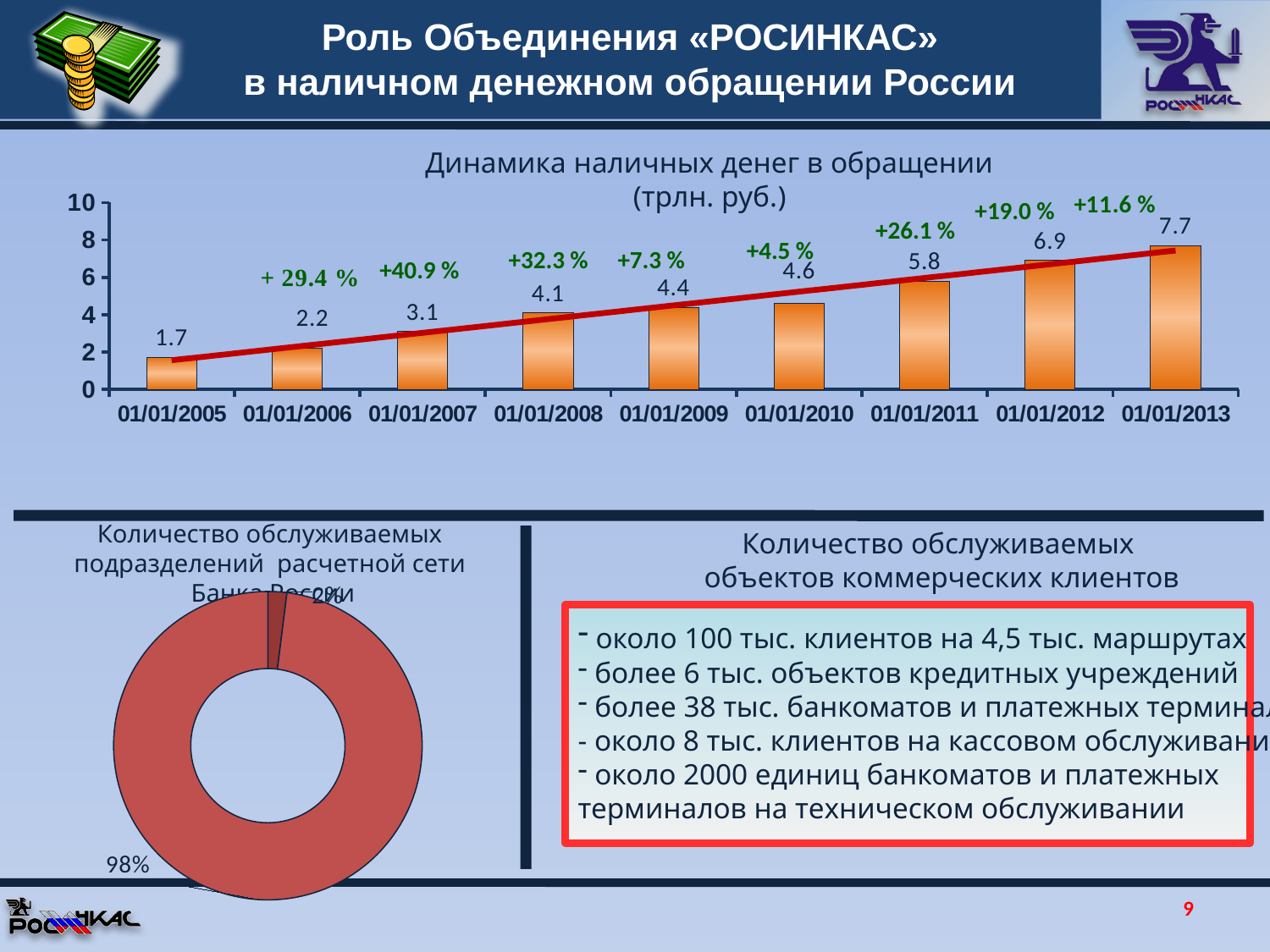
In the bar chart 'Динамика наличных денег в обращении', do the values rise or fall from 01/01/2005 to 01/01/2013? rise In the bar chart 'Динамика наличных денег в обращении', what is the value for 01/01/2013? 7.7 In the bar chart 'Динамика наличных денег в обращении', which date has the highest value? 01/01/2013 In the bar chart 'Динамика наличных денег в обращении', how many dates are shown on the x axis? 9 What kind of chart is 'Динамика наличных денег в обращении'? bar chart In the bar chart 'Динамика наличных денег в обращении', what percentage growth is labelled between 01/01/2006 and 01/01/2007? +40.9 % What kind of chart is shown at the bottom left of the slide? doughnut chart In the bar chart 'Динамика наличных денег в обращении', which date has the lowest value? 01/01/2005 In the bar chart 'Динамика наличных денег в обращении', what is the difference between the values for 01/01/2012 and 01/01/2011? 1.1 In the bar chart 'Динамика наличных денег в обращении', which is larger: the value for 01/01/2009 or 01/01/2010? 01/01/2010 In the bar chart 'Динамика наличных денег в обращении', what is the value for 01/01/2008? 4.1 In the doughnut chart at the bottom left ('Количество обслуживаемых подразделений расчетной сети Банка России'), what share does the large slice have? 98%